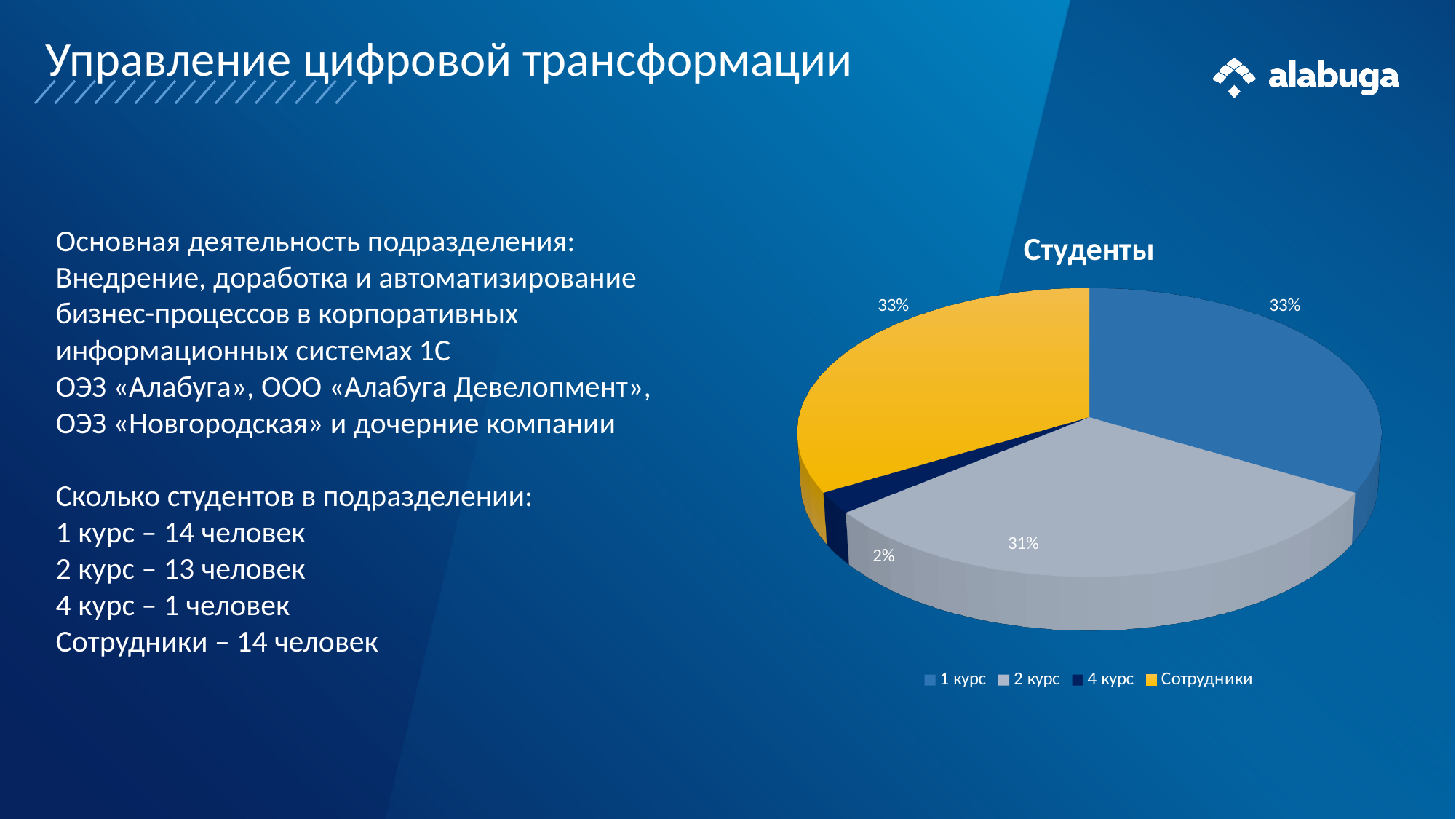
How many entries does the legend list? 4 What share of the pie does the 1 курс slice represent? 33% What colour is the Сотрудники slice in the pie chart? Yellow What share of the pie does the 2 курс slice represent? 31% What kind of chart is shown on the slide? Pie chart Which slice is larger, 2 курс or 4 курс? 2 курс Which category has the smallest slice of the pie? 4 курс What is the title of the chart? Студенты How many slices does the pie chart have? 4 What is the difference in percentage points between the 1 курс slice and the 2 курс slice? 2 What share of the pie does the 4 курс slice represent? 2%